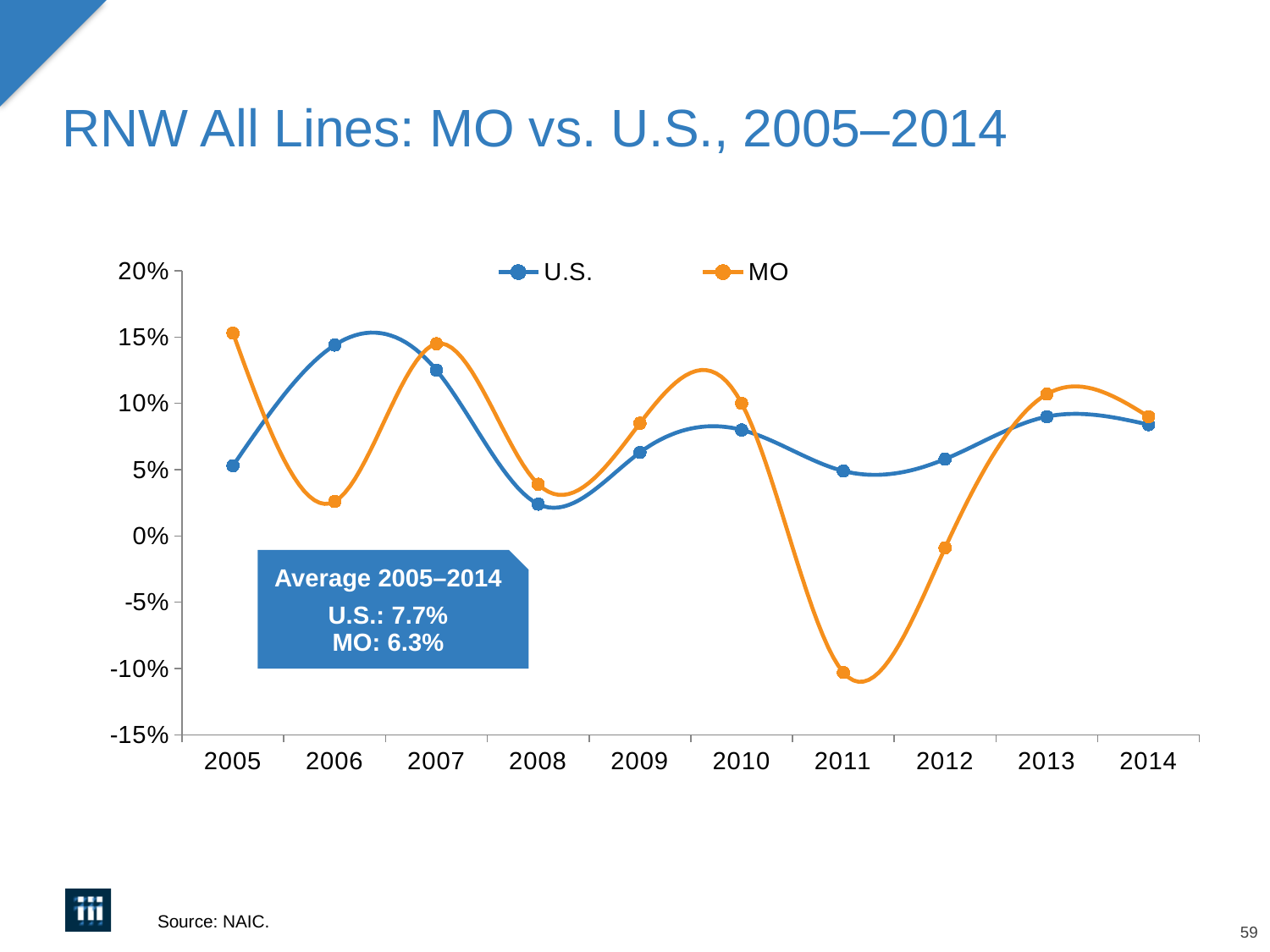
In which year is the MO value lowest? 2011 Is the MO value for 2011 greater or less than -5%? less How many years are plotted along the x axis? 10 How many series does the legend list? 2 What kind of chart is shown on the slide? line chart According to the text box, what is the U.S. average RNW for 2005–2014? 7.7% Is the MO value for 2006 greater or less than 5%? less Is the U.S. value for 2006 greater or less than 10%? greater In which year is the U.S. value lowest? 2008 In 2011, which series has the higher value, U.S. or MO? U.S. In which year is the U.S. value highest? 2006 In 2005, which series has the higher value, U.S. or MO? MO